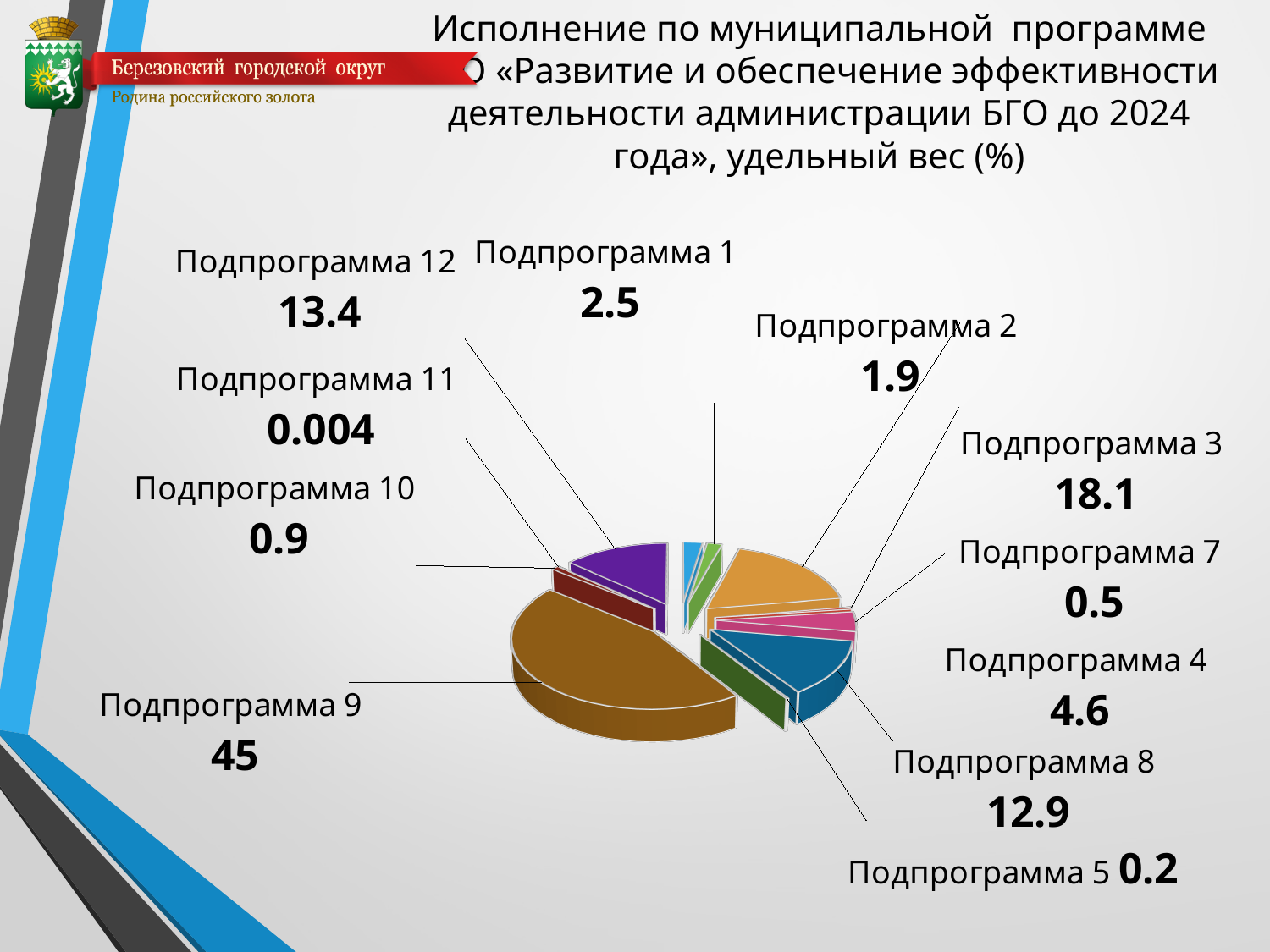
Which is larger, the value for Подпрограмма 8 or the value for Подпрограмма 4? Подпрограмма 8 What is the value for Подпрограмма 11 in the pie chart? 0.004 How many subprograms are shown as slices in the pie chart? 11 What is the value for Подпрограмма 8 in the pie chart? 12.9 What is the value for Подпрограмма 9 in the pie chart? 45 What is the difference between the values for Подпрограмма 3 and Подпрограмма 12? 4.7 What kind of chart is shown on the slide? Pie chart What is the value for Подпрограмма 3 in the pie chart? 18.1 What is the difference between the values for Подпрограмма 9 and Подпрограмма 3? 26.9 Which subprogram has the smallest value in the pie chart? Подпрограмма 11 Which subprogram has the largest share of the pie? Подпрограмма 9 What share of the pie does Подпрограмма 12 represent, as labelled? 13.4